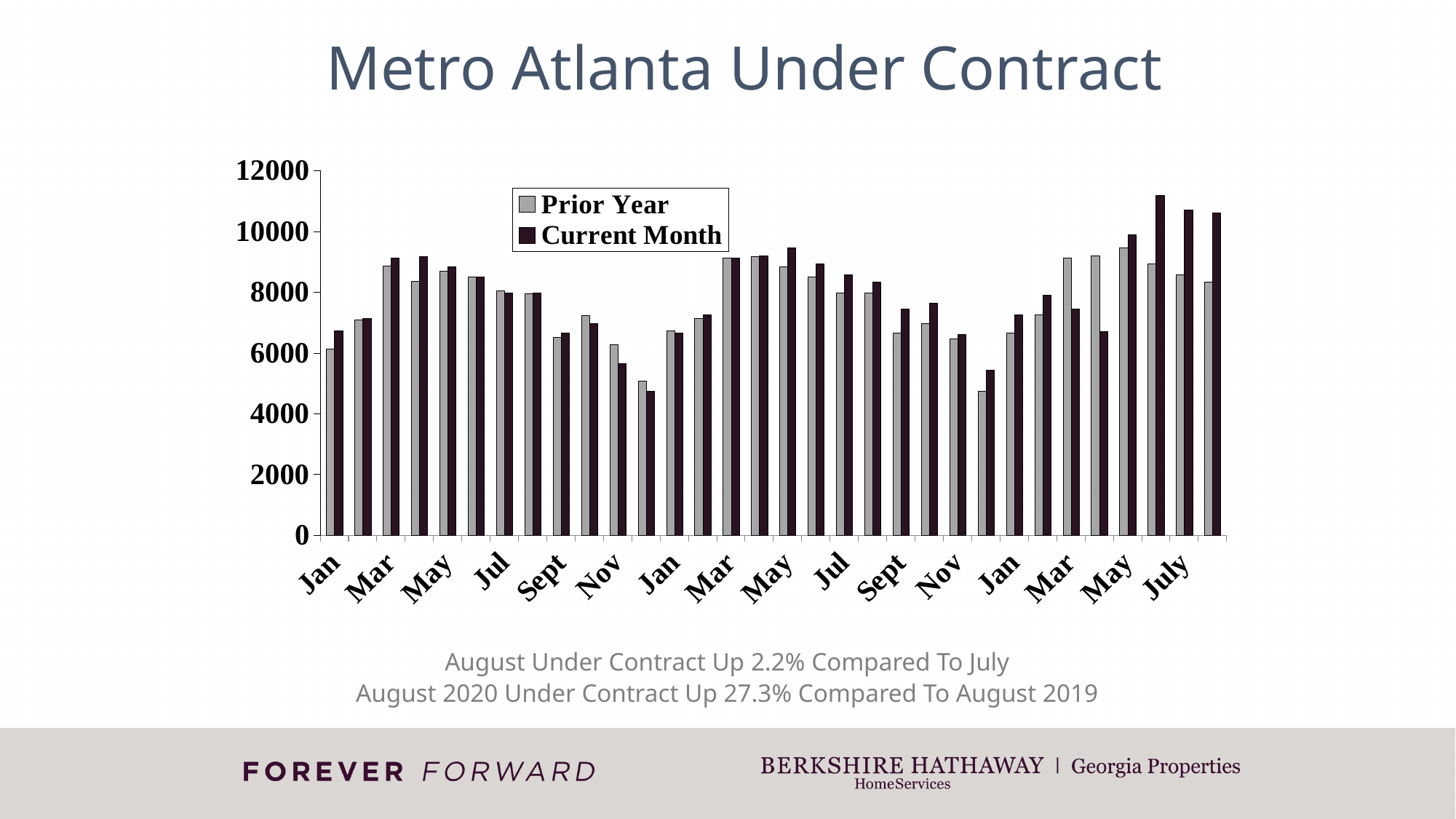
How many series does the legend list? 2 Is the Current Month value for the first Jan on the x axis greater or less than 6000? greater What is the title of the chart? Metro Atlanta Under Contract Is the Current Month value for the final month shown (the last pair of bars) greater or less than 10000? greater Do the Current Month values rise or fall from the first Jan to the first Mar on the x axis? rise Which series contains the tallest bar on the chart? Current Month Is the Prior Year value for the final month shown (the last pair of bars) greater or less than 10000? less For the final month shown (the last pair of bars), which series has the larger value, Prior Year or Current Month? Current Month What kind of chart is shown on the slide? Bar chart What are the two series named in the legend? Prior Year and Current Month